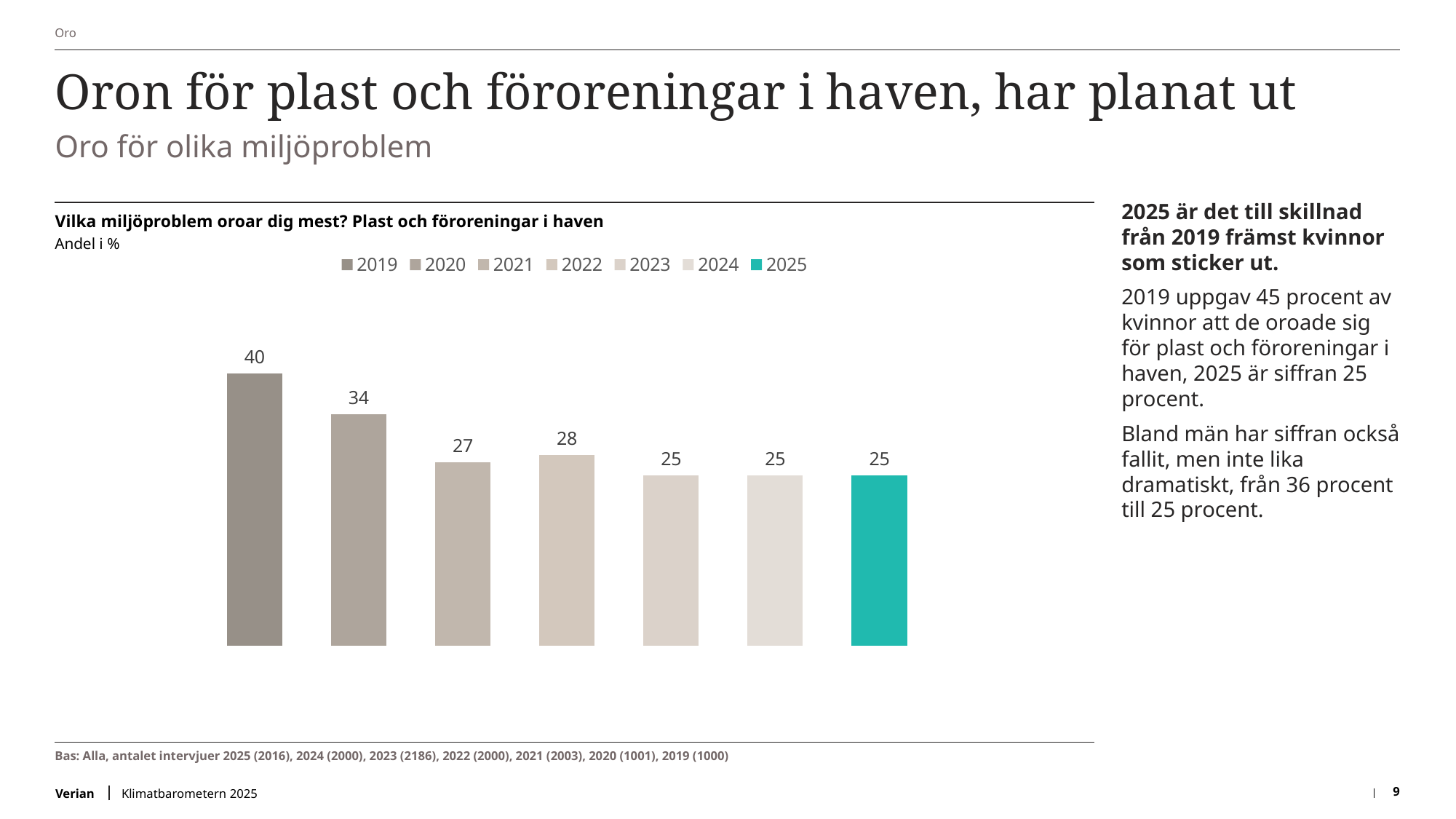
What is the value for 2022? 28 What kind of chart is shown on the slide? Bar chart What is the value for 2025? 25 How many entries does the legend list? 7 Which is larger, the value for 2021 or the value for 2022? 2022 Which year has the highest value? 2019 What is the difference between the values for 2019 and 2025? 15 How many bars are shown in the chart? 7 What is the difference between the values for 2020 and 2021? 7 Which year's bar is coloured teal? 2025 Do the values generally rise or fall from 2019 to 2025? Fall What is the value for 2019? 40